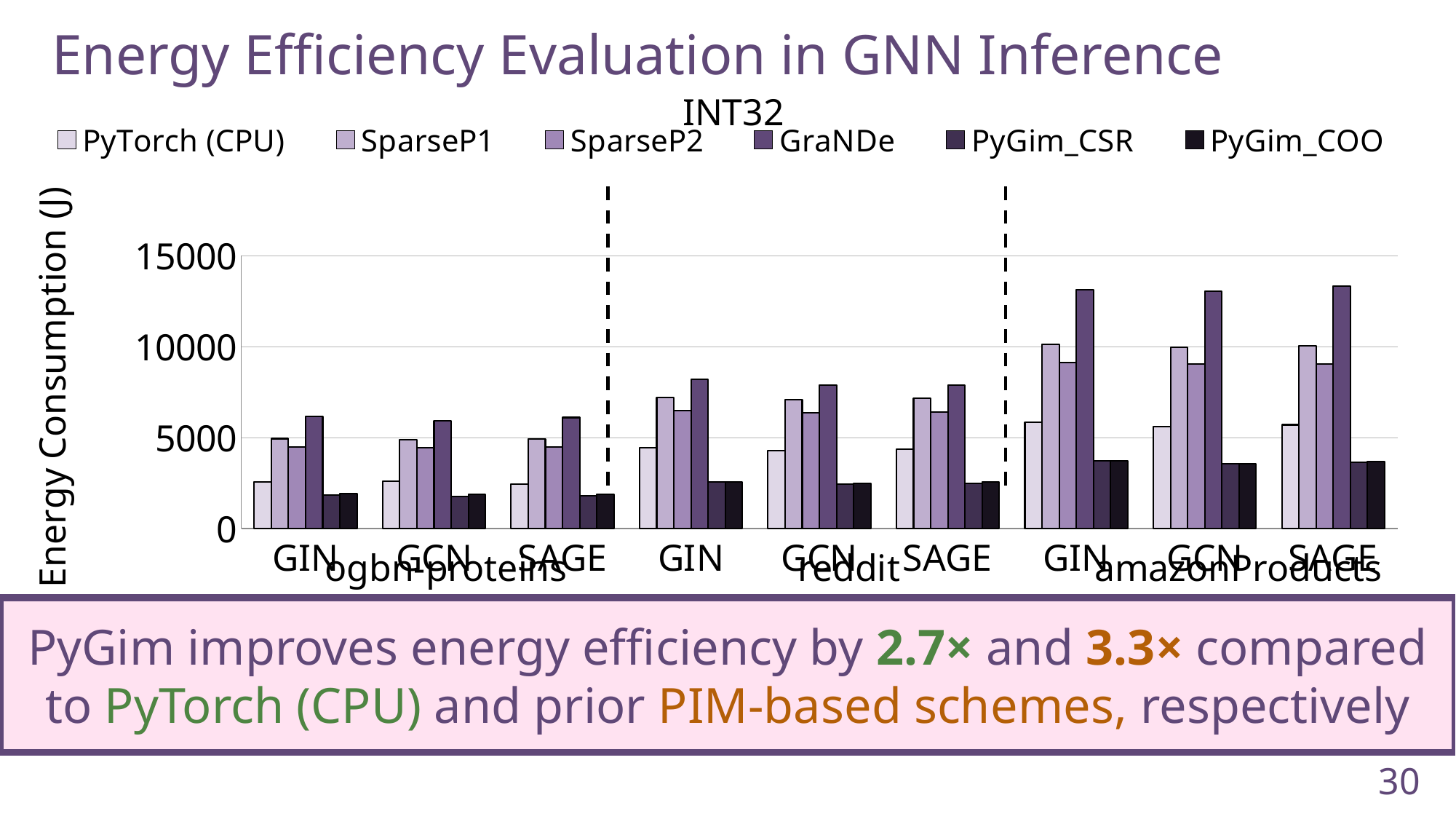
For GCN on reddit, which is larger: the GraNDe value or the PyTorch (CPU) value? GraNDe What is the label of the y axis? Energy Consumption (J) How many GNN model categories are plotted along the x axis in total? 9 Is the PyTorch (CPU) value for GIN on ogbn-proteins greater or less than 5000? less What is the title of the chart? INT32 Which dataset has the highest GraNDe energy consumption values? amazonProducts Is the GraNDe value for GIN on amazonProducts greater or less than 10000? greater What kind of chart is shown on the slide? bar chart Which series has the highest energy consumption for GIN on amazonProducts? GraNDe How many series does the legend list? 6 Is the SparseP1 value for GIN on reddit greater or less than 5000? greater